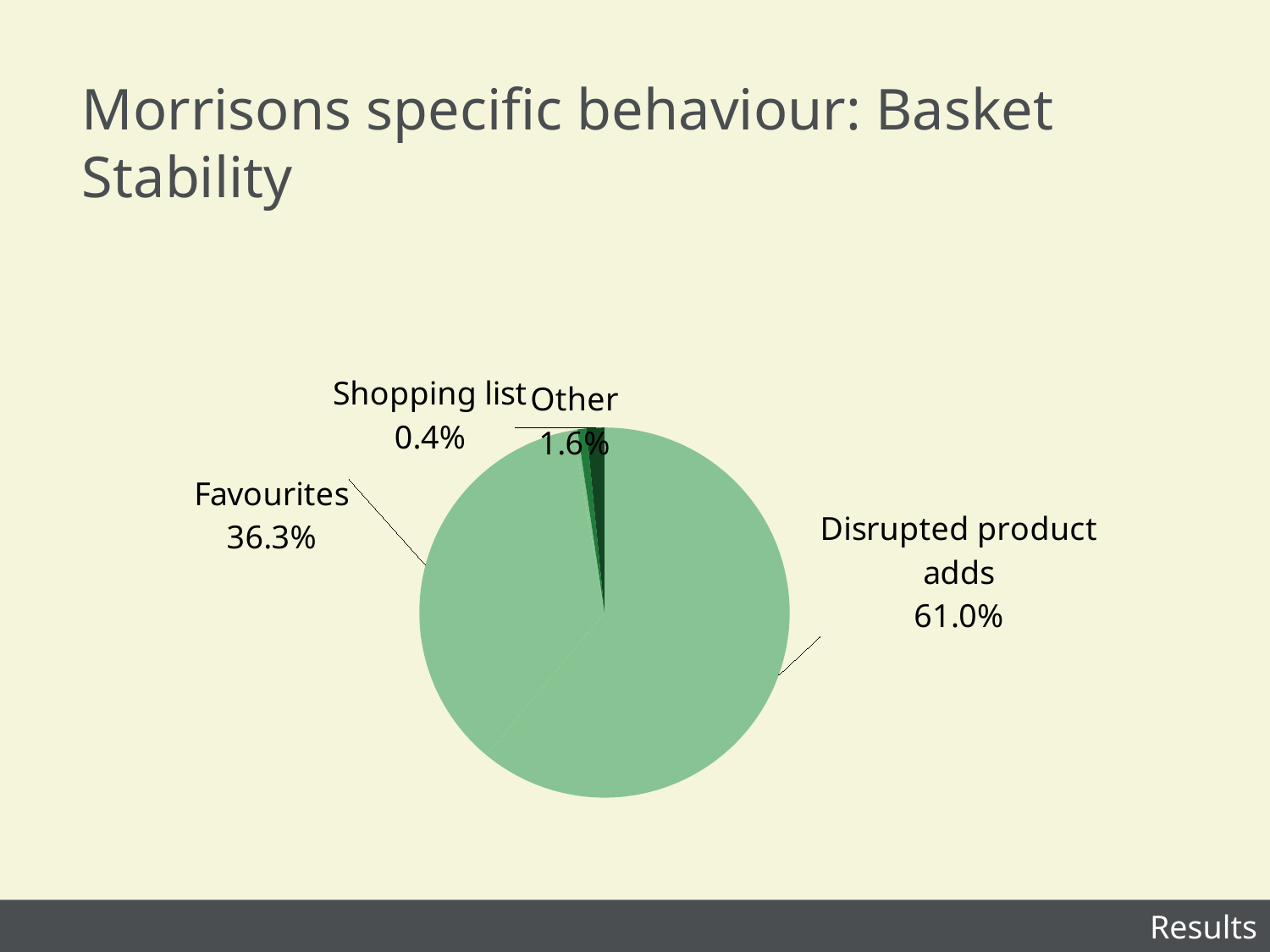
What is the difference in percentage points between Disrupted product adds and Favourites? 24.7 What is the difference in percentage points between Other and Shopping list? 1.2 Which is larger, Other or Shopping list? Other What type of chart is shown on the slide? pie chart What is the title of the slide containing the pie chart? Morrisons specific behaviour: Basket Stability What percentage of the pie is Disrupted product adds? 61.0% What percentage of the pie is Favourites? 36.3% What percentage of the pie is Other? 1.6% What percentage of the pie is Shopping list? 0.4% Which slice of the pie is the largest? Disrupted product adds Which slice of the pie is the smallest? Shopping list